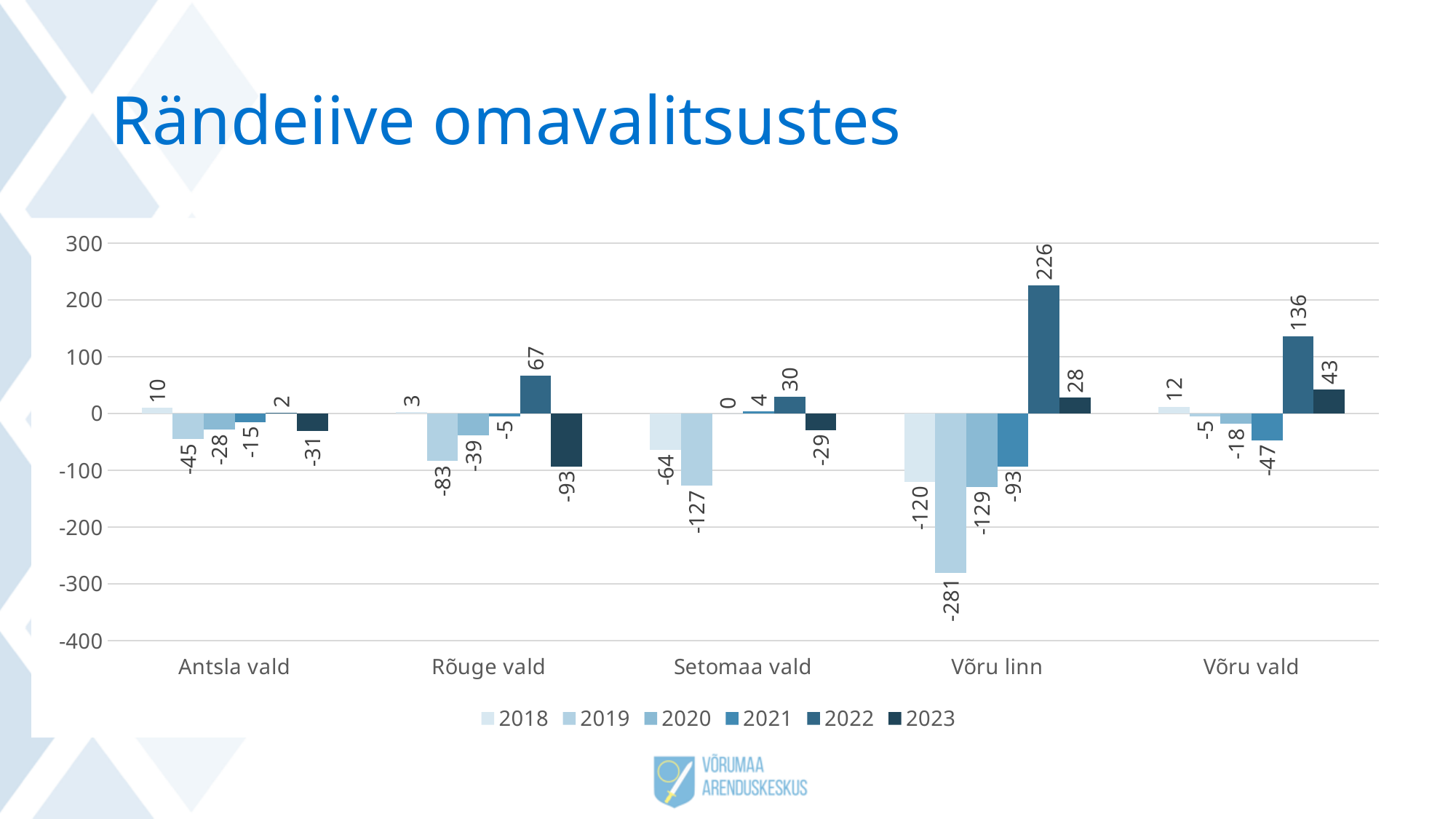
How many categories are shown on the x axis? 5 Which category has the highest value in 2022? Võru linn What is the title of the slide? Rändeiive omavalitsustes What is the value for Setomaa vald in 2019? -127 What is the value for Rõuge vald in 2023? -93 What is the value for Antsla vald in 2018? 10 What is the difference between the 2022 values for Võru linn and Võru vald? 90 How many series does the legend list? 6 What is the value for Võru linn in 2022? 226 What kind of chart is shown on the slide? bar chart Which is larger, the 2023 value for Võru vald or the 2023 value for Võru linn? Võru vald Which category has the lowest value in 2019? Võru linn